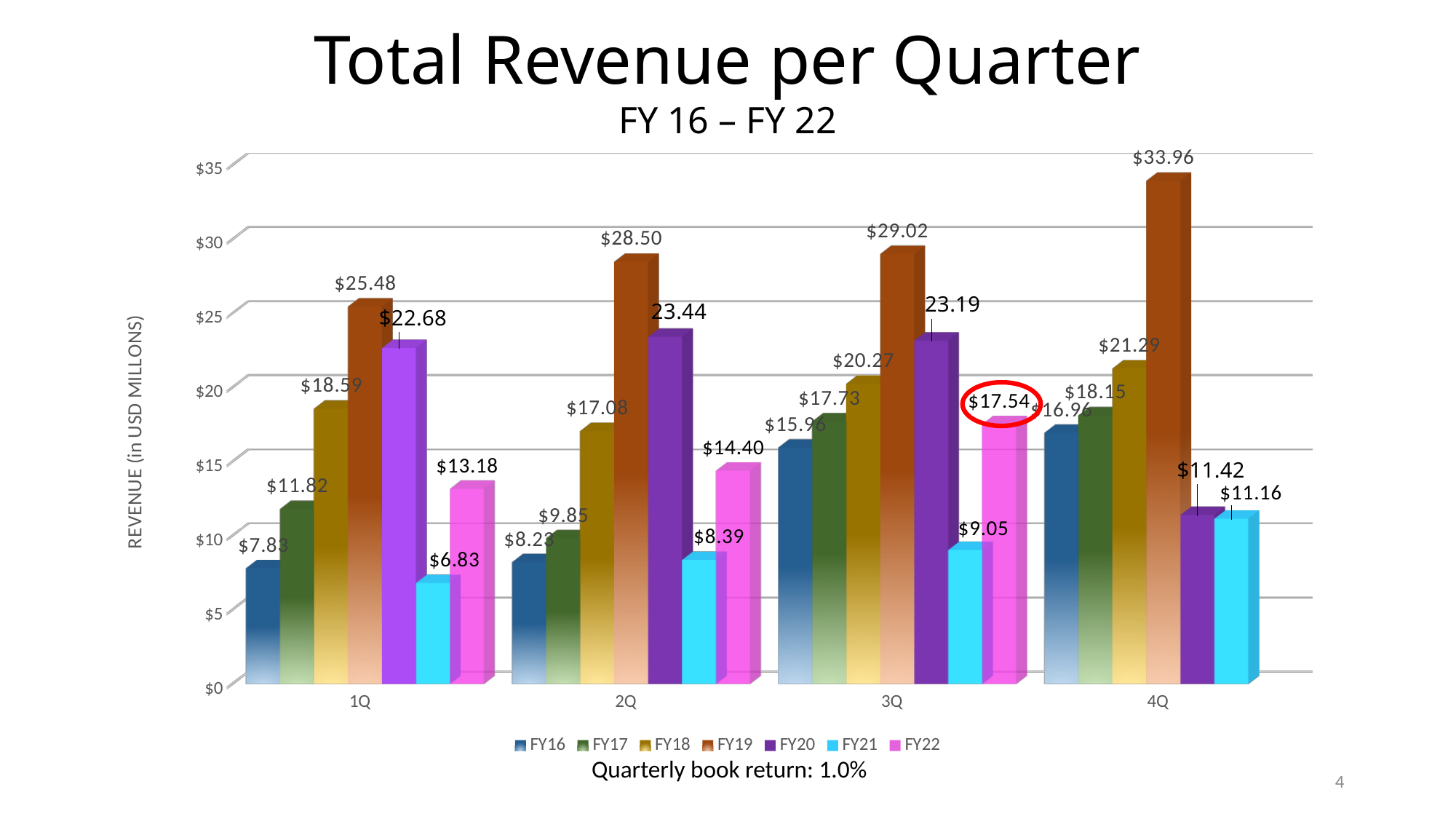
In which quarter is FY19 revenue highest? 4Q How many quarters are shown on the x axis? 4 What kind of chart is shown on the slide? Bar chart How many series does the legend list? 7 What is the FY21 revenue in 1Q? $6.83 What is the FY22 revenue in 3Q (the circled value)? $17.54 In 1Q, which is larger: FY18 revenue or FY17 revenue? FY18 What is the FY20 revenue in 2Q? 23.44 What is the difference between FY22 revenue in 2Q and in 1Q? $1.22 What is the FY19 revenue in 4Q? $33.96 In which quarter is FY21 revenue lowest? 1Q What is the difference between FY19 revenue in 4Q and in 3Q? $4.94